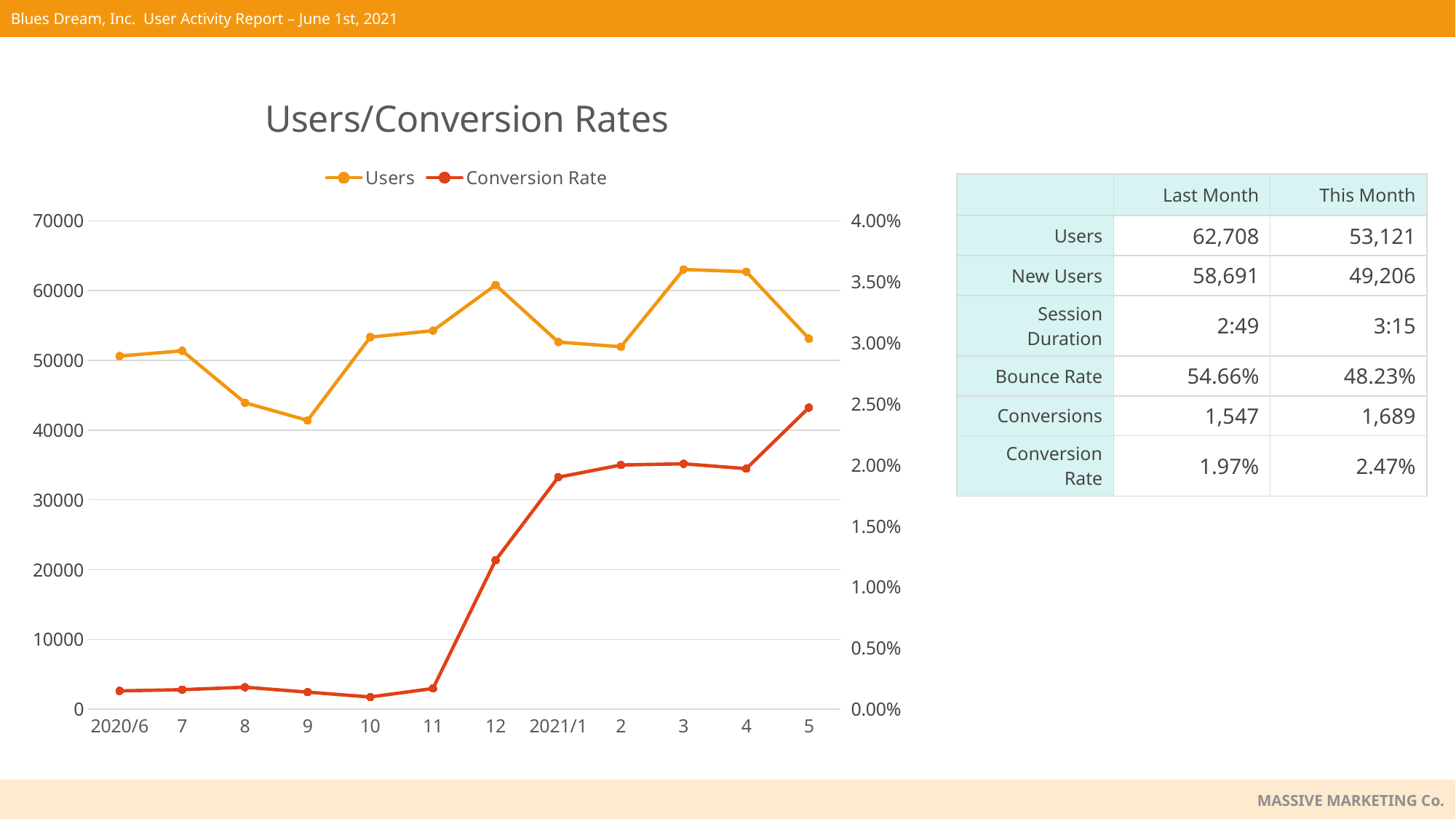
Is the Conversion Rate for month 11 greater or less than 0.50%? less Is the Users value for month 9 greater or less than 50000? less Is the Users value for month 3 (2021) greater or less than 60000? greater What kind of chart is shown on the slide? Line chart What is the title of the chart? Users/Conversion Rates In which month is the Users series at its lowest? 9 Does the Conversion Rate rise or fall between month 11 and 2021/1? rise In which month is the Conversion Rate series at its highest? 5 How many series does the chart legend list? 2 Which month has more Users, 2020/6 or 10? 10 How many months are plotted along the x axis of the chart? 12